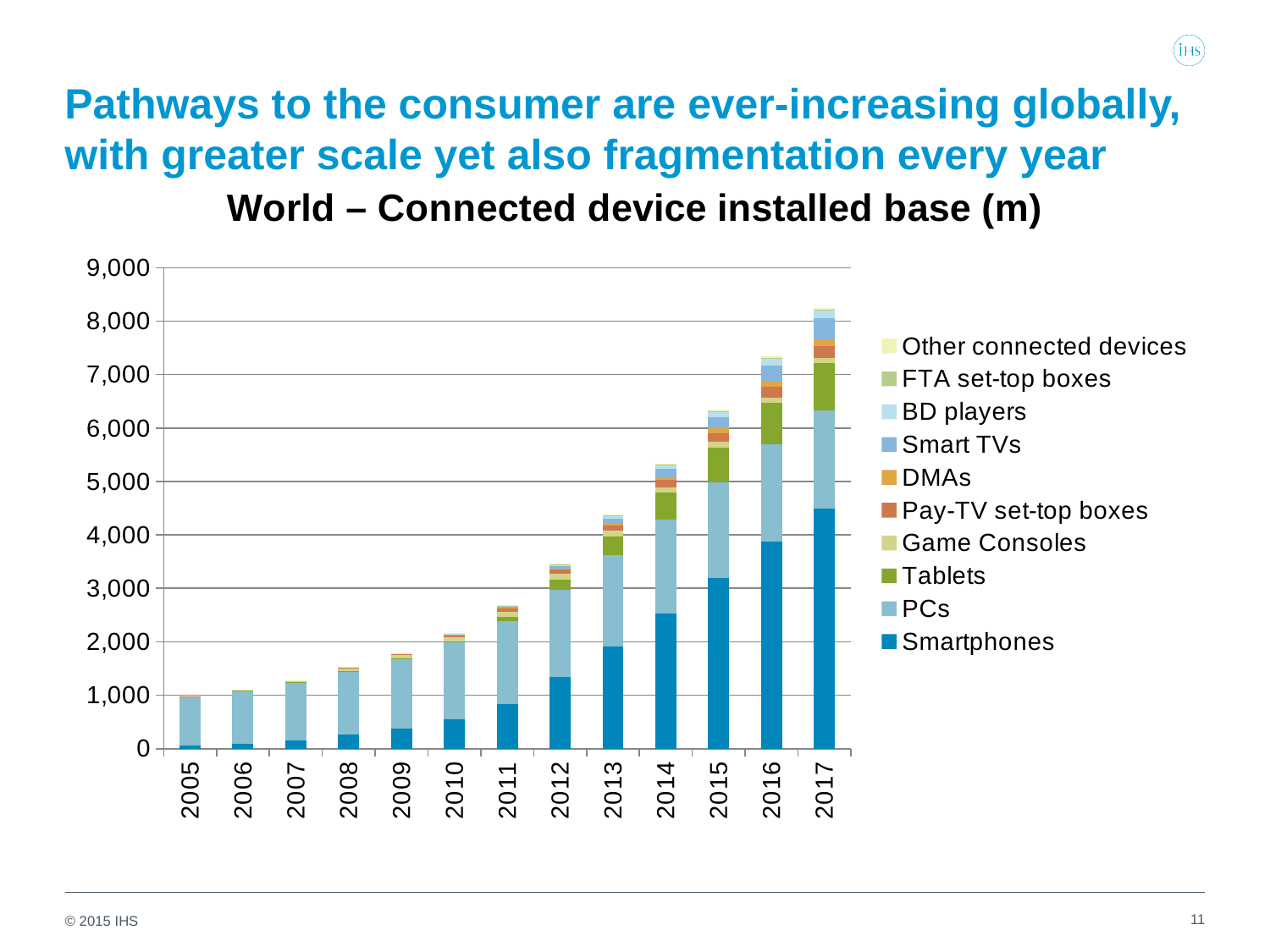
Is the Smartphones value for 2017 greater or less than 4,000? greater Is the total installed base for 2017 greater or less than 8,000? greater What is the title of the chart? World – Connected device installed base (m) Which year has the lowest total connected device installed base? 2005 Which series is shown at the bottom of each stacked bar? Smartphones Is the total installed base for 2016 greater or less than 7,000? greater Which year has the highest total connected device installed base? 2017 What kind of chart is shown on the slide? Stacked bar chart Do the total bar heights rise or fall from 2005 to 2017? Rise How many series does the legend list? 10 How many years are shown on the x axis? 13